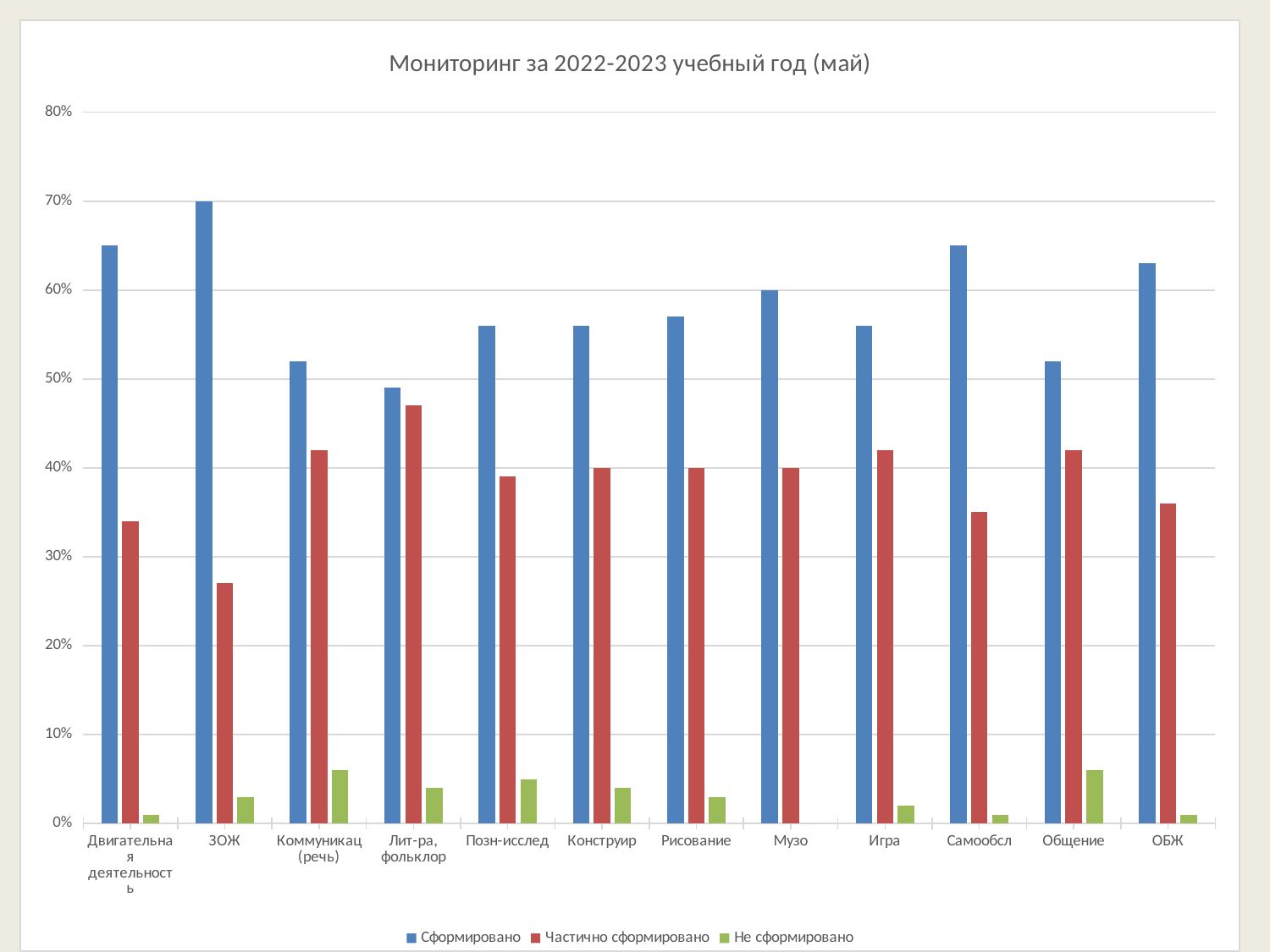
What kind of chart is shown on the slide? bar chart Which category has the highest value for the Частично сформировано series? Лит-ра, фольклор What is the Сформировано value for Музо? 60% Which is larger for Коммуникац (речь): the Сформировано value or the Частично сформировано value? Сформировано Is the Частично сформировано value for ЗОЖ greater or less than 30%? less How many categories are shown along the x axis? 12 Which category has the highest value for the Сформировано series? ЗОЖ Is the Сформировано value for Самообсл greater or less than 60%? greater Which category has the lowest value for the Сформировано series? Лит-ра, фольклор What is the title of the chart? Мониторинг за 2022-2023 учебный год (май) What is the Сформировано value for ЗОЖ? 70% How many series does the legend list? 3